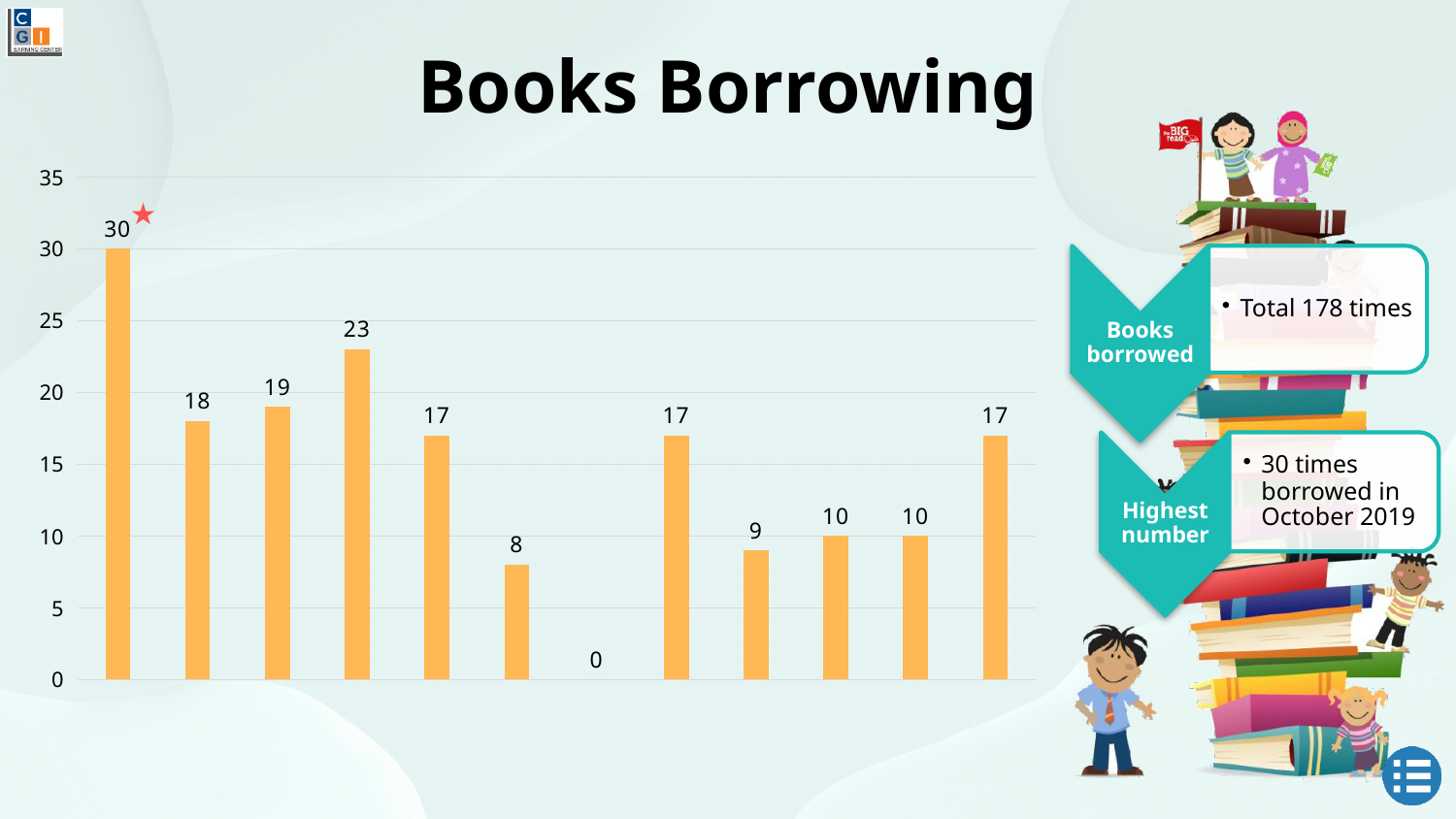
What is the value of the seventh bar from the left? 0 What is the highest value shown in the chart? 30 Is the value of the sixth bar from the left greater or less than 10? less What is the title of the slide containing the chart? Books Borrowing How many bars are plotted in the chart? 12 What is the difference between the first bar (30) and the fourth bar (23)? 7 What is the lowest value shown in the chart? 0 What kind of chart is shown on the slide? bar chart What is the value of the fourth bar from the left? 23 What is the value of the first (leftmost) bar in the chart? 30 Which is larger, the second bar from the left or the third bar from the left? the third bar (19) What is the total of all the bar values in the chart? 178